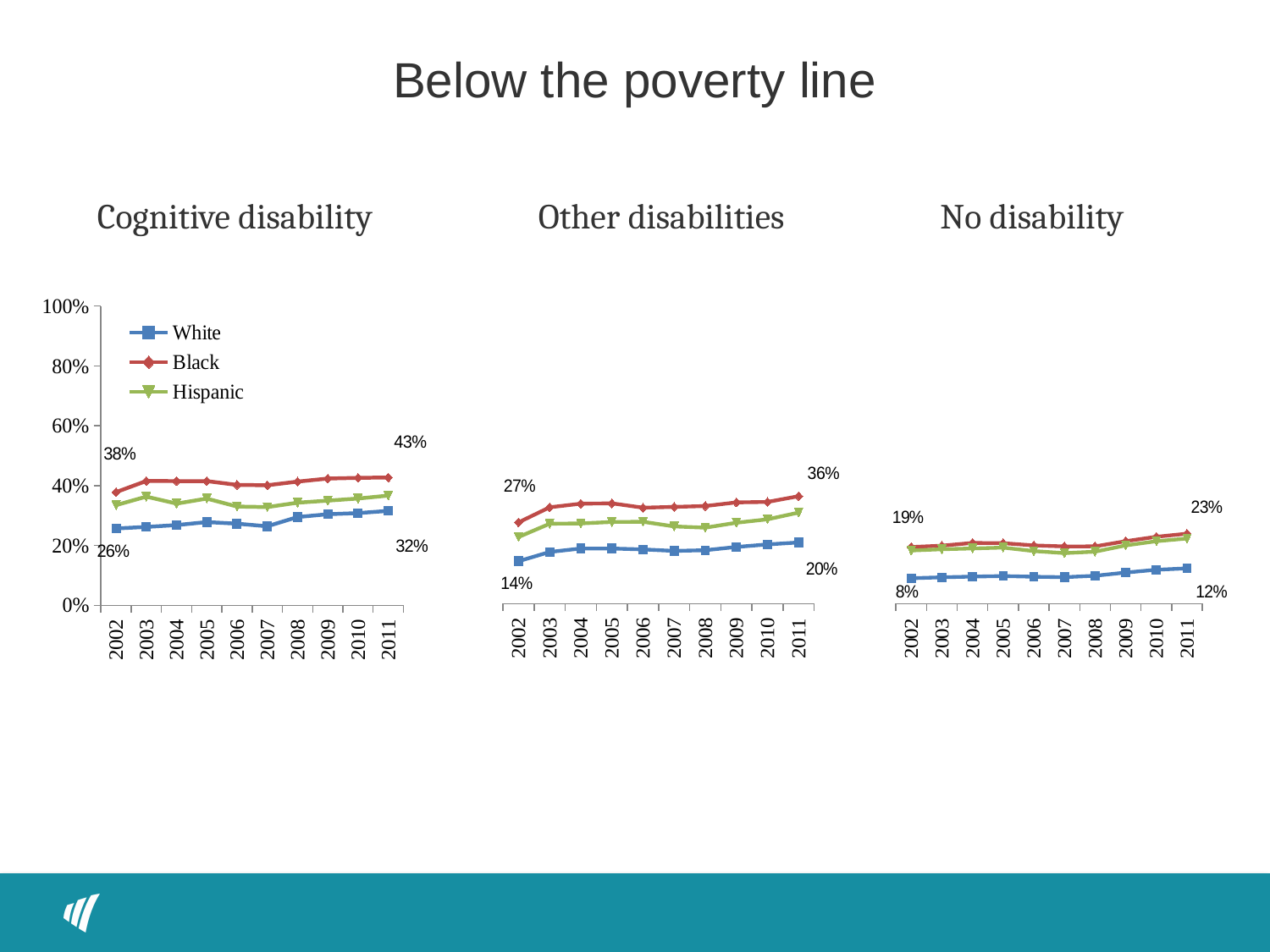
In the Cognitive disability chart, what is the value for White in 2002? 26% In the Cognitive disability chart, what is the value for Black in 2011? 43% How many series does the legend in the Cognitive disability chart list? 3 In the Other disabilities chart, does the White series rise or fall from 2002 to 2011? rise In the Cognitive disability chart, is the Hispanic value in 2011 greater or less than 20%? greater In the Other disabilities chart, what is the value for Black in 2002? 27% In the Cognitive disability chart, which series has the highest values across the years? Black How many years are shown on the x axis of the No disability chart? 10 In the No disability chart, what is the value for White in 2011? 12% In the Cognitive disability chart, what is the difference between the Black value in 2011 and the Black value in 2002? 5% In the No disability chart, which is larger in 2002, the Black value or the White value? Black In the Other disabilities chart, what is the difference between the Black and White values in 2011? 16%